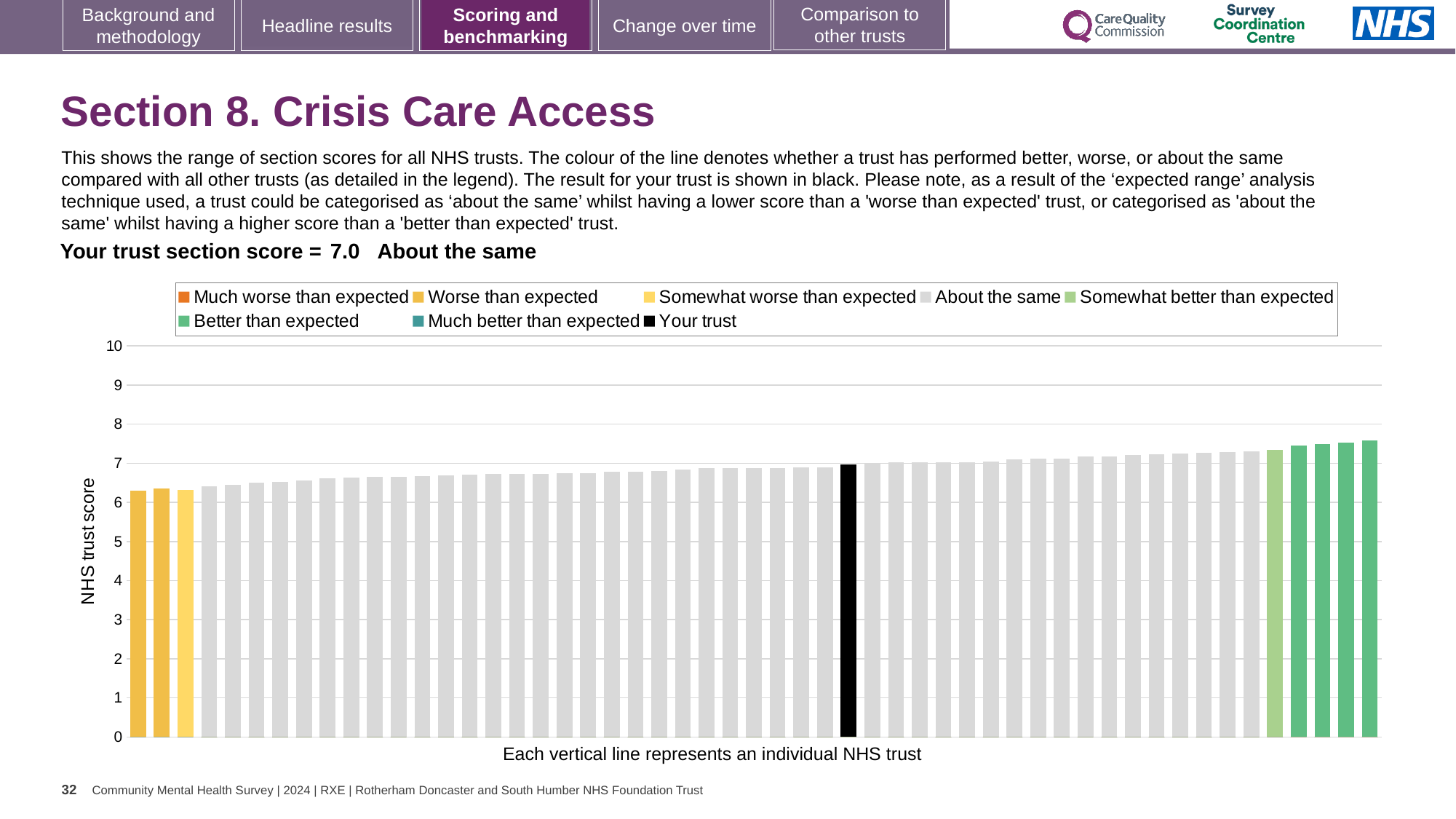
How many bars are coloured as 'Worse than expected' (yellow)? 2 Which legend category does the tallest bar on the chart belong to? Better than expected How is your trust's score categorised compared with other trusts? About the same Is the value of the leftmost bar on the chart greater or less than 7? less How many bars are coloured as 'Better than expected' (green)? 4 What is the section score for your trust shown on the slide? 7.0 What kind of chart is shown on the slide? bar chart How many entries does the chart legend list? 8 What is the label on the vertical axis of the chart? NHS trust score Is the value of the black 'Your trust' bar greater or less than 5? greater Do the bar values rise or fall from left to right across the chart? rise Is the value of the tallest bar on the chart greater or less than 7? greater